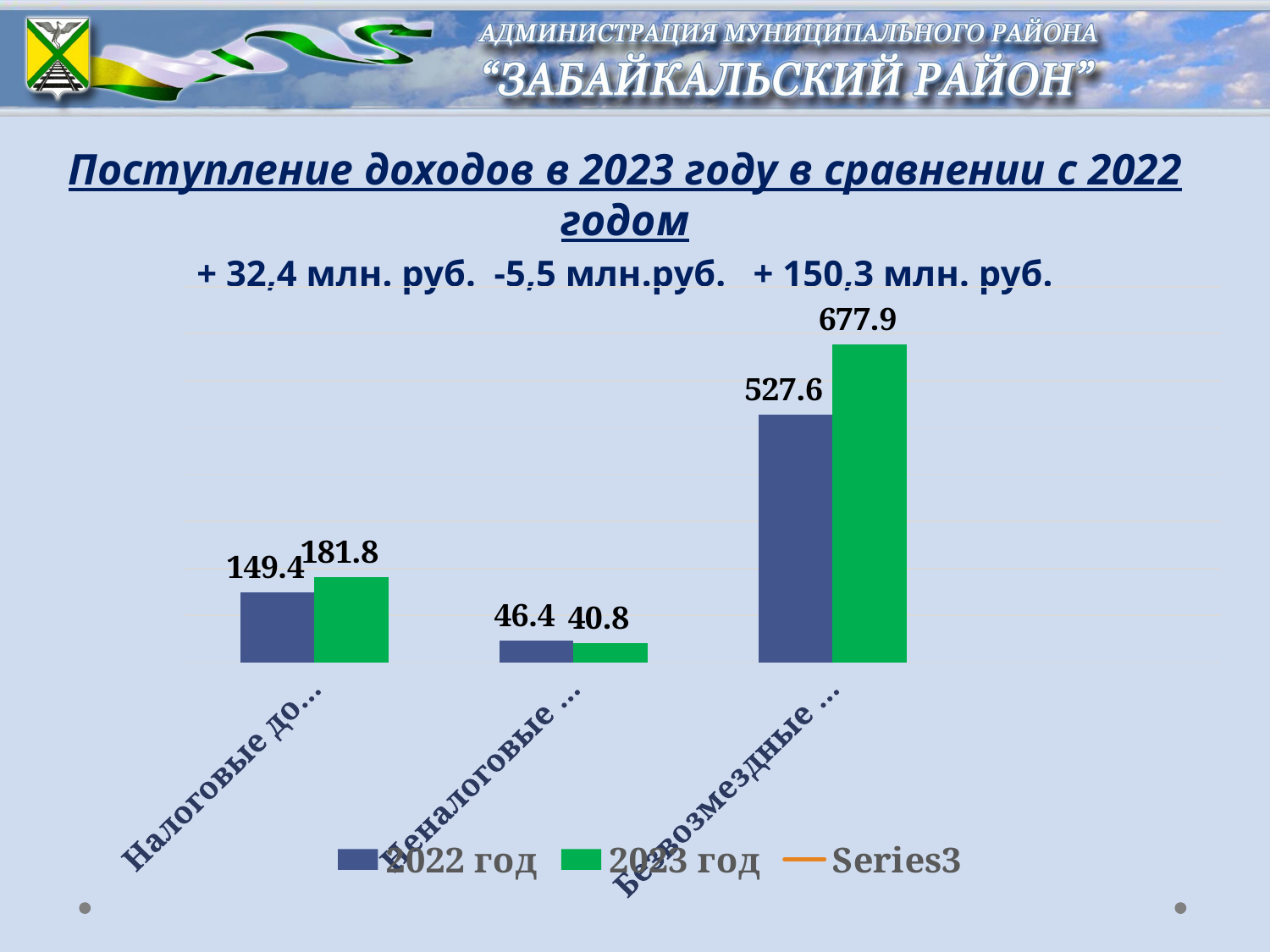
What is the value for 2023 год in the category Безвозмездные ...? 677.9 What is the value for 2023 год in the category Налоговые до...? 181.8 Which category has the lowest value for 2022 год? Неналоговые ... What is the difference between the 2023 год and 2022 год values in the category Безвозмездные ...? 150.3 In the category Неналоговые ..., which is larger: the 2022 год value or the 2023 год value? 2022 год Which category has the highest value for 2023 год? Безвозмездные ... What is the name of the third series listed in the chart legend? Series3 What is the value for 2022 год in the category Неналоговые ...? 46.4 What type of chart is shown on the slide? bar chart How many series does the chart legend list? 3 What is the value for 2022 год in the category Налоговые до...? 149.4 How many categories are shown on the x axis of the chart? 3